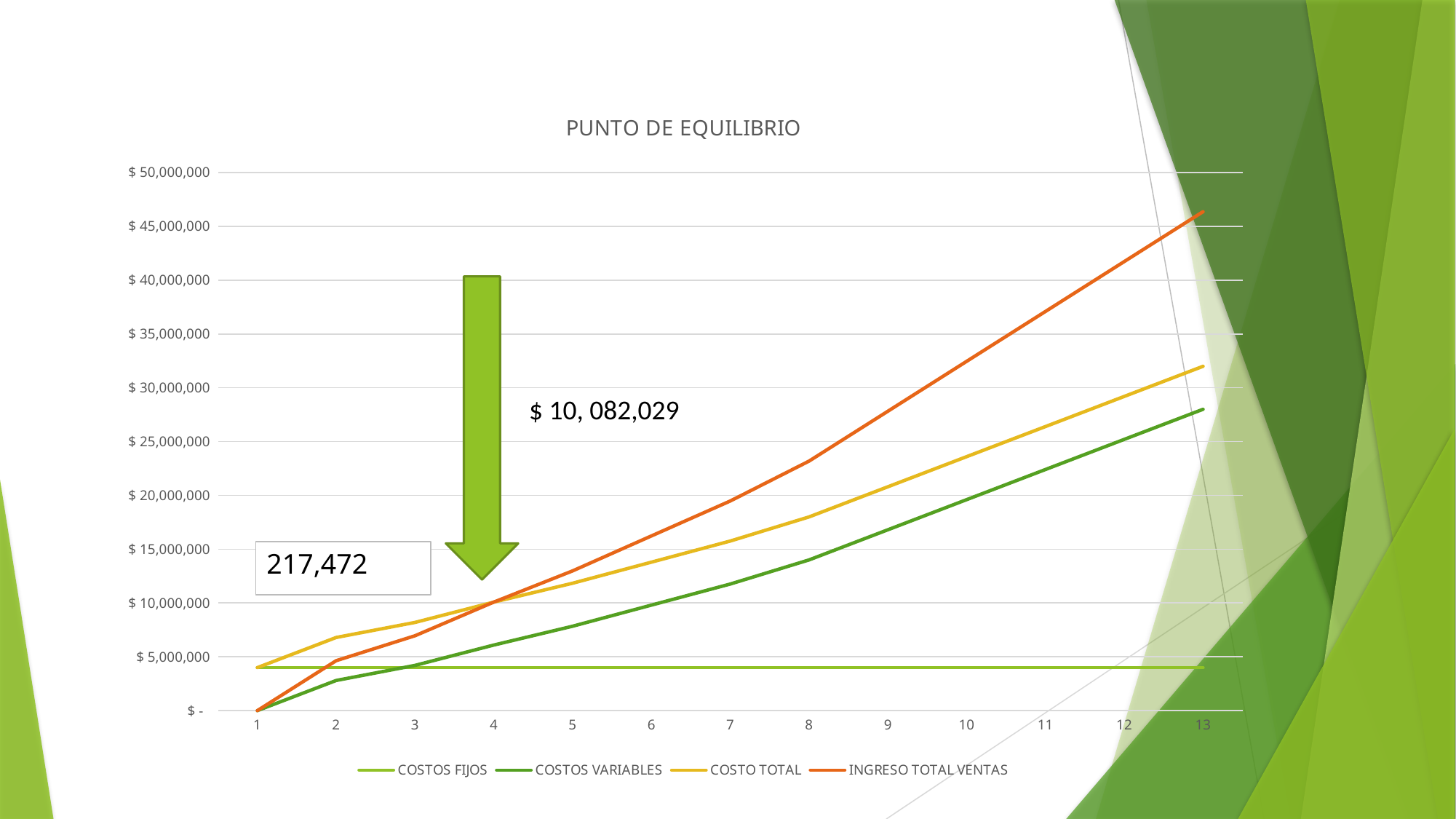
At x = 8, which is larger: INGRESO TOTAL VENTAS or COSTO TOTAL? INGRESO TOTAL VENTAS How many series does the legend list? 4 How many points are there along the x axis? 13 What kind of chart is shown on the slide? line chart At x = 2, which is larger: COSTO TOTAL or INGRESO TOTAL VENTAS? COSTO TOTAL Does the INGRESO TOTAL VENTAS line rise or fall from x = 1 to x = 13? rise Is the value of COSTO TOTAL at x = 13 greater or less than $ 35,000,000? less What value is printed next to the green arrow pointing at the break-even point? $ 10, 082,029 Is the value of COSTOS FIJOS greater or less than $ 5,000,000? less Which series has the highest value at x = 13? INGRESO TOTAL VENTAS Which series has the lowest value at x = 13? COSTOS FIJOS Is the value of INGRESO TOTAL VENTAS at x = 13 greater or less than $ 40,000,000? greater